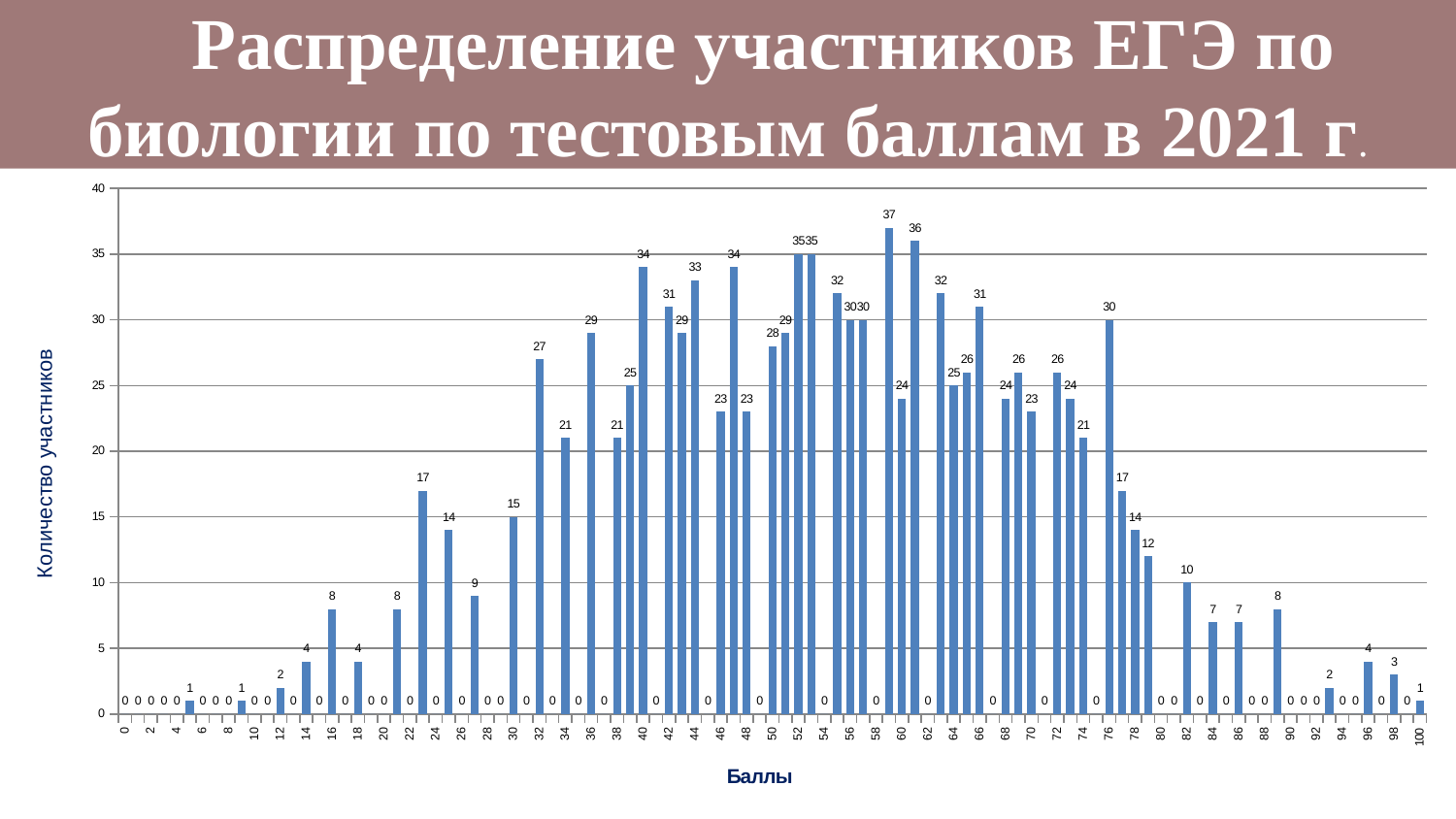
What is the label of the vertical axis? Количество участников What is the difference between the number of participants with 22 points and with 24 points? 0 Is the number of participants with 40 points greater or less than 30? greater How many participants scored 82 points? 10 How many participants scored 22 points? 0 How many participants scored 76 points? 30 How many participants scored 100 points? 1 What kind of chart is shown on the slide? bar chart Do the values generally rise or fall along the x axis from score 82 to score 100? fall What is the label of the horizontal axis? Баллы What is the highest number of participants shown for any score on the chart? 37 Which score has more participants, 76 or 82? 76